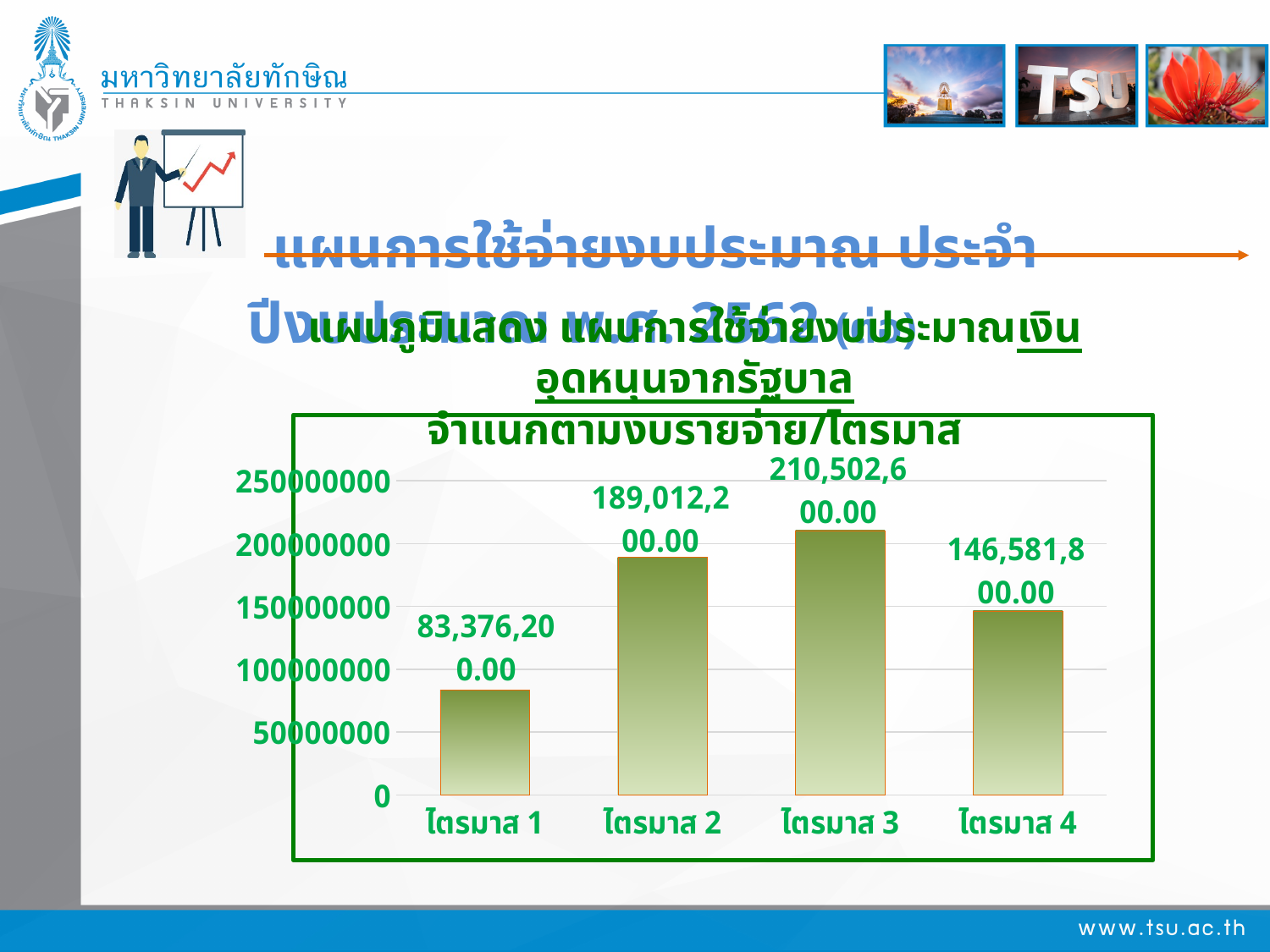
How many quarters (ไตรมาส) are plotted in the chart? 4 Which is larger, the value for ไตรมาส 2 or ไตรมาส 4? ไตรมาส 2 What is the value for ไตรมาส 1? 83,376,200.00 Which quarter has the highest value? ไตรมาส 3 What is the value for ไตรมาส 3? 210,502,600.00 What type of chart is shown on the slide? bar chart What is the difference between the values for ไตรมาส 3 and ไตรมาส 2? 21,490,400.00 Which quarter has the lowest value? ไตรมาส 1 What is the value for ไตรมาส 2? 189,012,200.00 Is the value for ไตรมาส 4 greater or less than 150000000? less What is the difference between the values for ไตรมาส 2 and ไตรมาส 1? 105,636,000.00 What is the value for ไตรมาส 4? 146,581,800.00